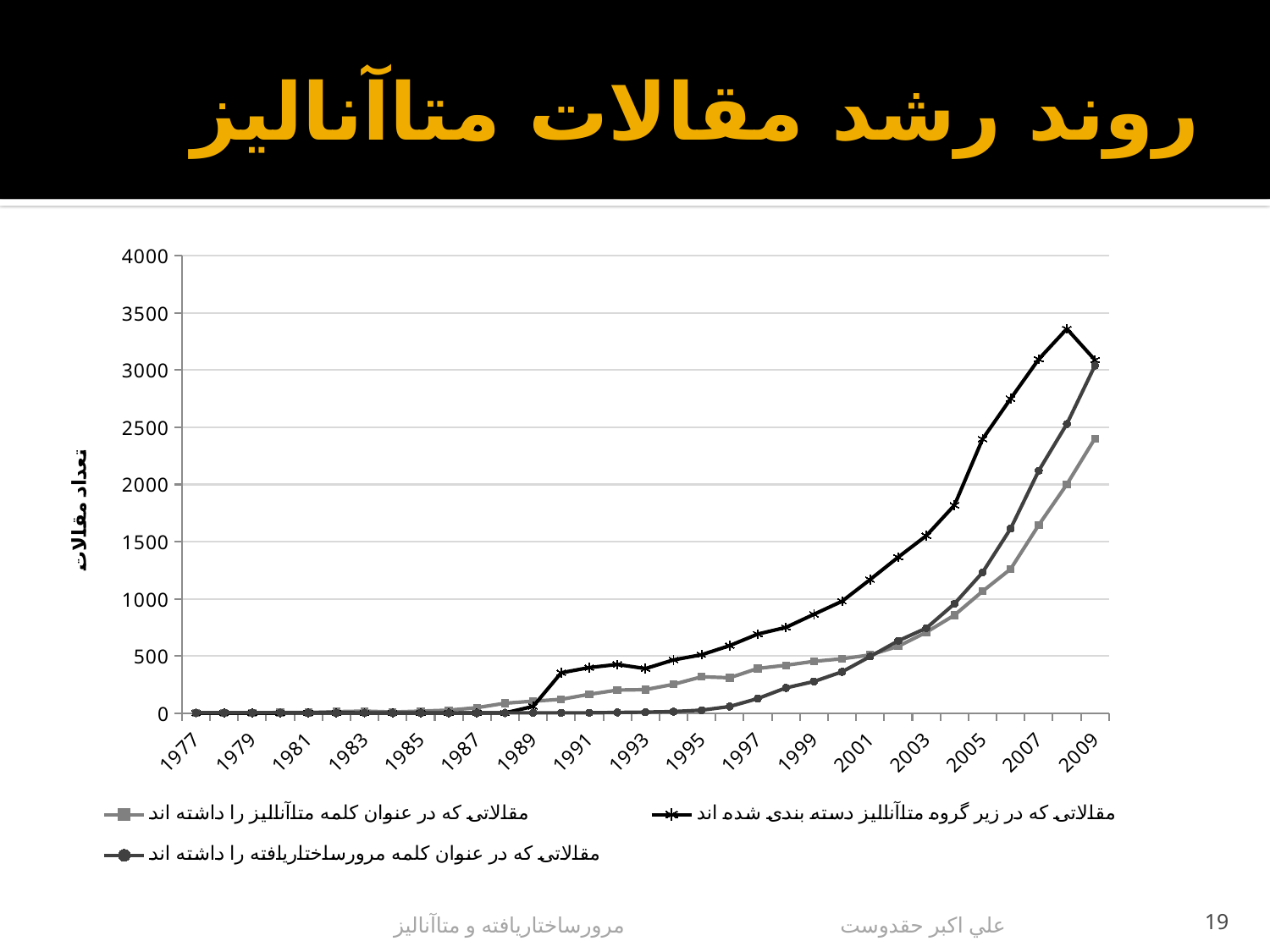
In 2009, which is larger: the value for 'مقالاتی که در عنوان کلمه متاآنالیز را داشته اند' or for 'مقالاتی که در زیر گروه متاآنالیز دسته بندی شده اند'? مقالاتی که در زیر گروه متاآنالیز دسته بندی شده اند What is the label on the vertical axis? تعداد مقالات In 1995, which is larger: the value for 'مقالاتی که در عنوان کلمه متاآنالیز را داشته اند' or for 'مقالاتی که در عنوان کلمه مرورساختاریافته را داشته اند'? مقالاتی که در عنوان کلمه متاآنالیز را داشته اند In which year does the series 'مقالاتی که در زیر گروه متاآنالیز دسته بندی شده اند' reach its highest value? 2008 Is the 2009 value for 'مقالاتی که در عنوان کلمه متاآنالیز را داشته اند' greater or less than 2500? less Is the 2001 value for 'مقالاتی که در زیر گروه متاآنالیز دسته بندی شده اند' greater or less than 1000? greater What is the title of the chart? روند رشد مقالات متاآنالیز Is the 2008 value for 'مقالاتی که در زیر گروه متاآنالیز دسته بندی شده اند' greater or less than 3000? greater What kind of chart is shown on the slide? line chart How many series does the legend list? 3 Which series has the highest value in 2008? مقالاتی که در زیر گروه متاآنالیز دسته بندی شده اند Do the values of the series 'مقالاتی که در زیر گروه متاآنالیز دسته بندی شده اند' generally rise or fall from 1977 to 2008? rise